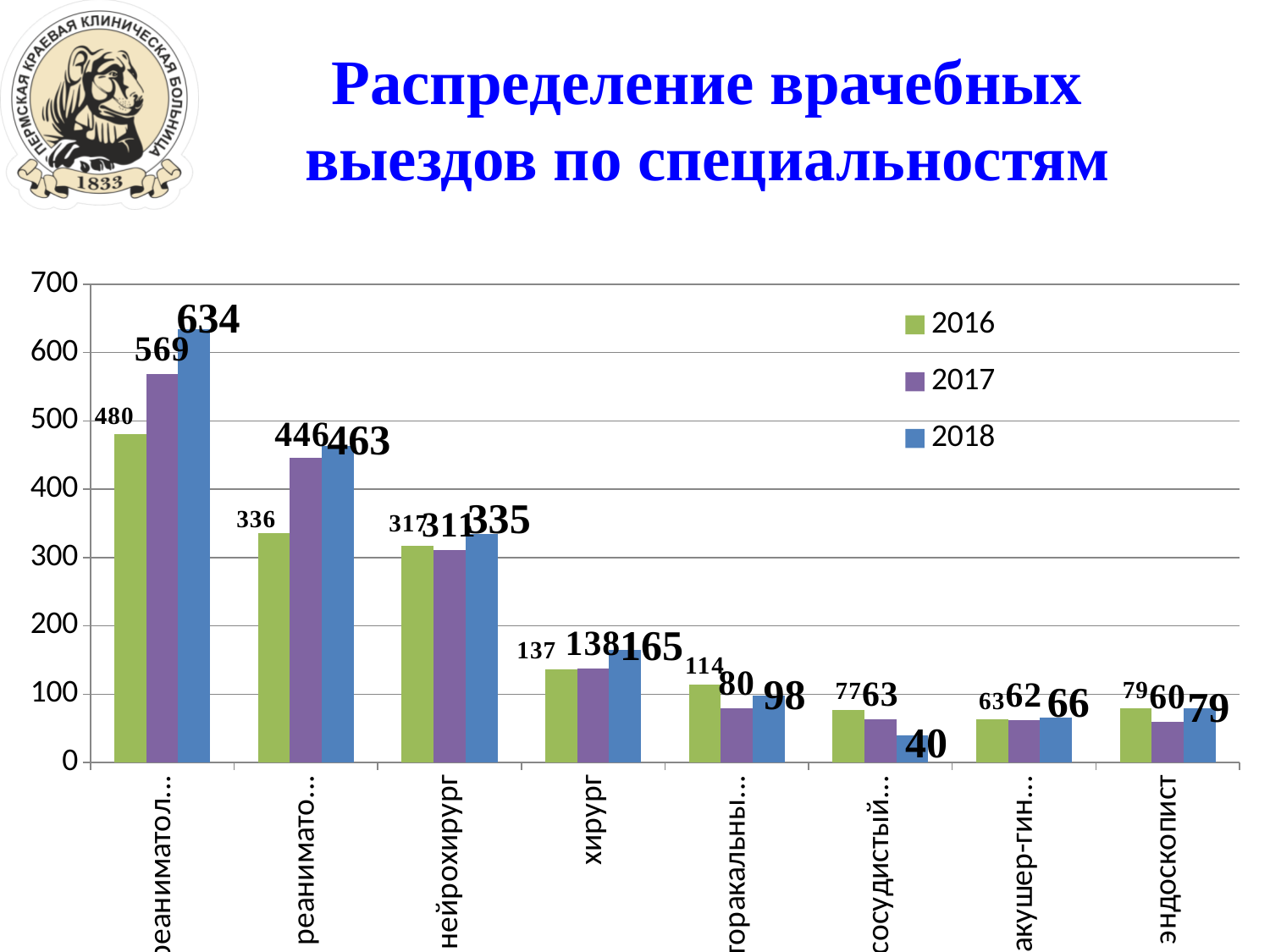
For эндоскопист, which year has the lowest value? 2017 How many series does the legend list? 3 What are the entries listed in the legend? 2016, 2017, 2018 What is the value for хирург in 2018? 165 What is the difference between the 2018 and 2016 values for хирург? 28 What kind of chart is shown on the slide? bar chart How many specialty categories are shown on the x axis? 8 What is the value for нейрохирург in 2016? 317 What is the difference between the 2016 and 2017 values for нейрохирург? 6 For хирург, which year has the highest value? 2018 What is the value for эндоскопист in 2017? 60 For нейрохирург, which year has the larger value, 2017 or 2018? 2018